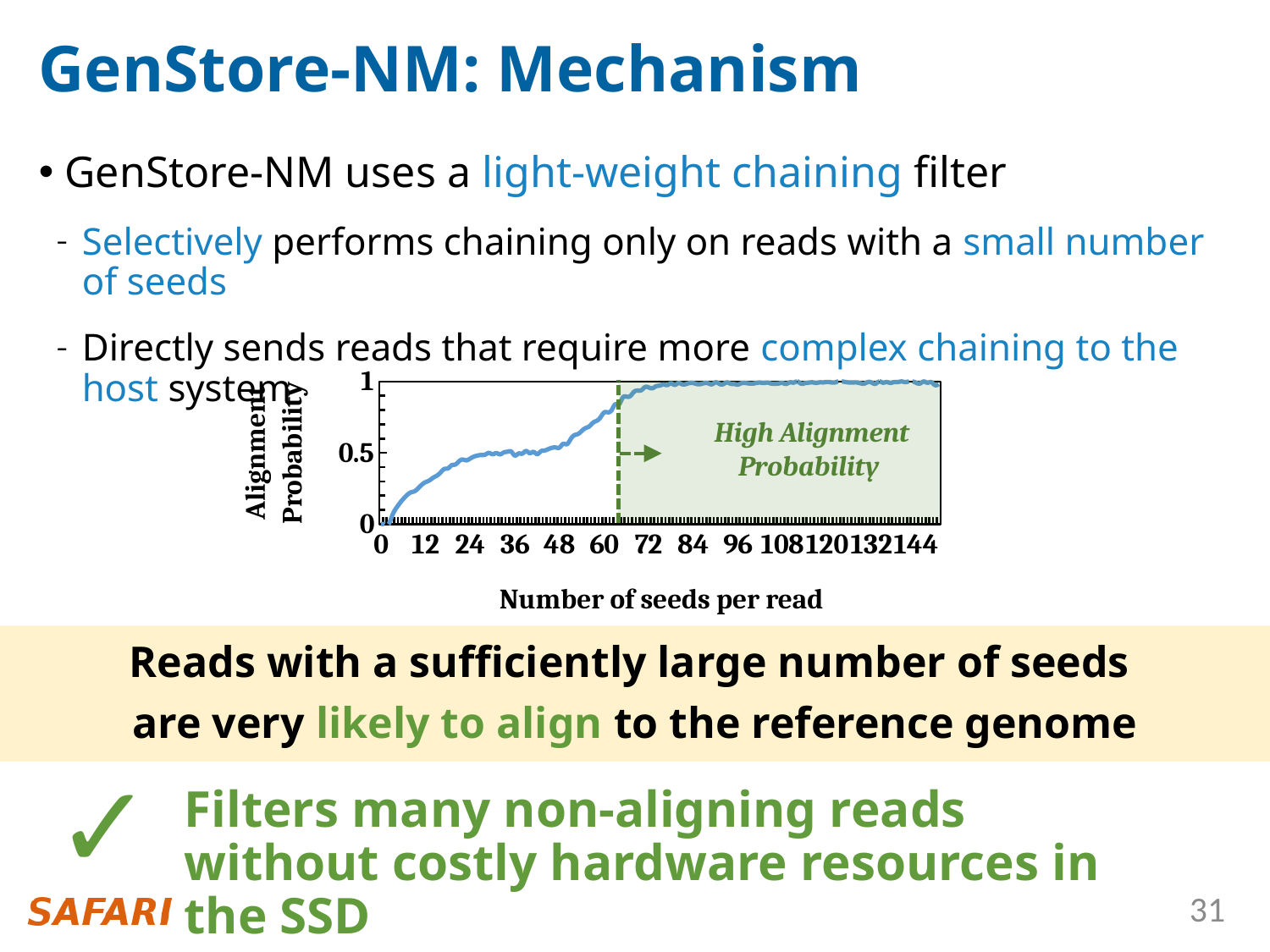
What is the highest value shown on the y axis of the chart? 1 Which has the higher alignment probability: 24 seeds per read or 96 seeds per read? 96 seeds per read Is the alignment probability at 12 seeds per read greater or less than 0.5? less Is the alignment probability at 84 seeds per read greater or less than 0.5? greater What is the label of the x axis of the chart? Number of seeds per read What kind of chart is shown on the slide? line chart Does the alignment probability rise or fall as the number of seeds per read increases? rise What is the largest tick value shown on the x axis of the chart? 144 Is the alignment probability at 120 seeds per read greater or less than 0.5? greater